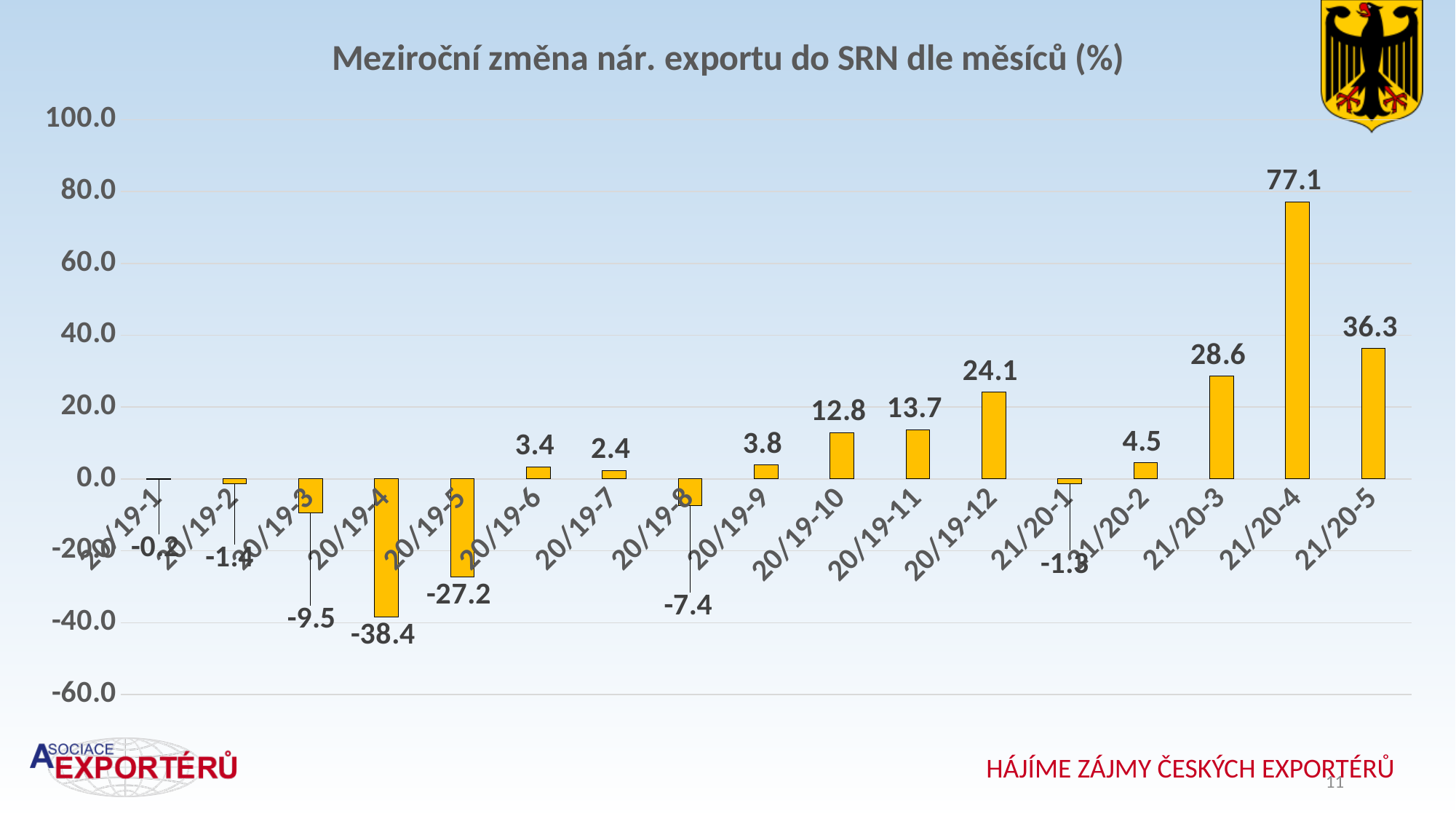
What is the difference between the values for 20/19-11 and 20/19-10? 0.9 What is the title of the chart? Meziroční změna nár. exportu do SRN dle měsíců (%) What is the value for 21/20-4? 77.1 Which month has the highest value? 21/20-4 How many months are shown on the x axis? 17 Which is larger, the value for 21/20-3 or the value for 20/19-12? 21/20-3 What is the value for 20/19-12? 24.1 What is the value for 20/19-4? -38.4 Which month has the lowest value? 20/19-4 What is the difference between the values for 21/20-4 and 21/20-5? 40.8 What kind of chart is shown on the slide? bar chart What is the value for 20/19-8? -7.4